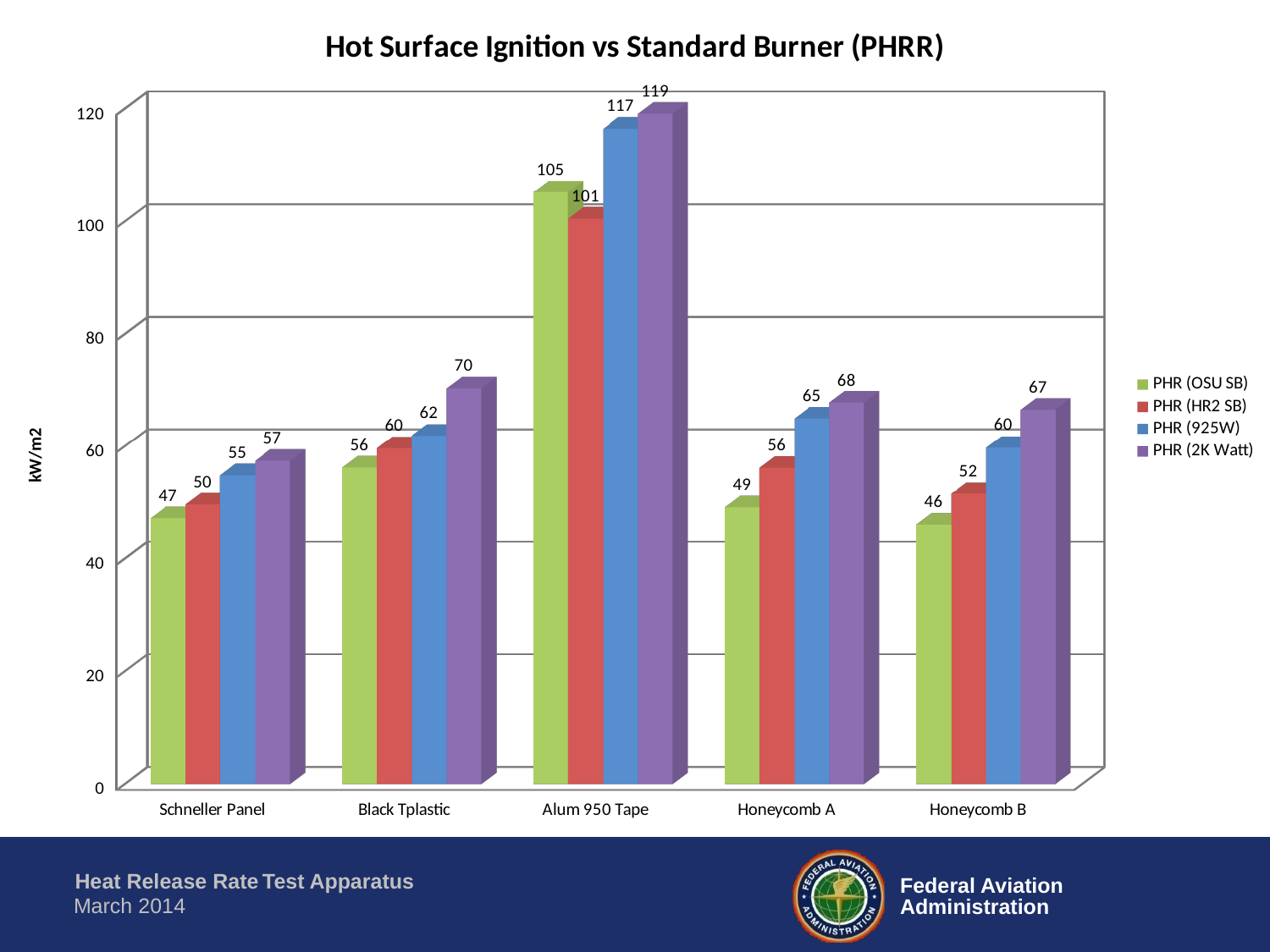
What kind of chart is shown on the slide? Bar chart What is the PHR (925W) value for Black Tplastic? 62 Which category has the highest PHR (HR2 SB) value? Alum 950 Tape Which category has the lowest PHR (OSU SB) value? Honeycomb B What is the PHR (OSU SB) value for Honeycomb B? 46 Which is larger for Schneller Panel: PHR (925W) or PHR (HR2 SB)? PHR (925W) What is the PHR (2K Watt) value for Alum 950 Tape? 119 How many series does the legend list? 4 What is the difference between the PHR (2K Watt) and PHR (OSU SB) values for Honeycomb A? 19 What is the title of the chart? Hot Surface Ignition vs Standard Burner (PHRR) Is the PHR (OSU SB) value for Alum 950 Tape greater or less than 100? greater How many categories are shown on the x axis? 5